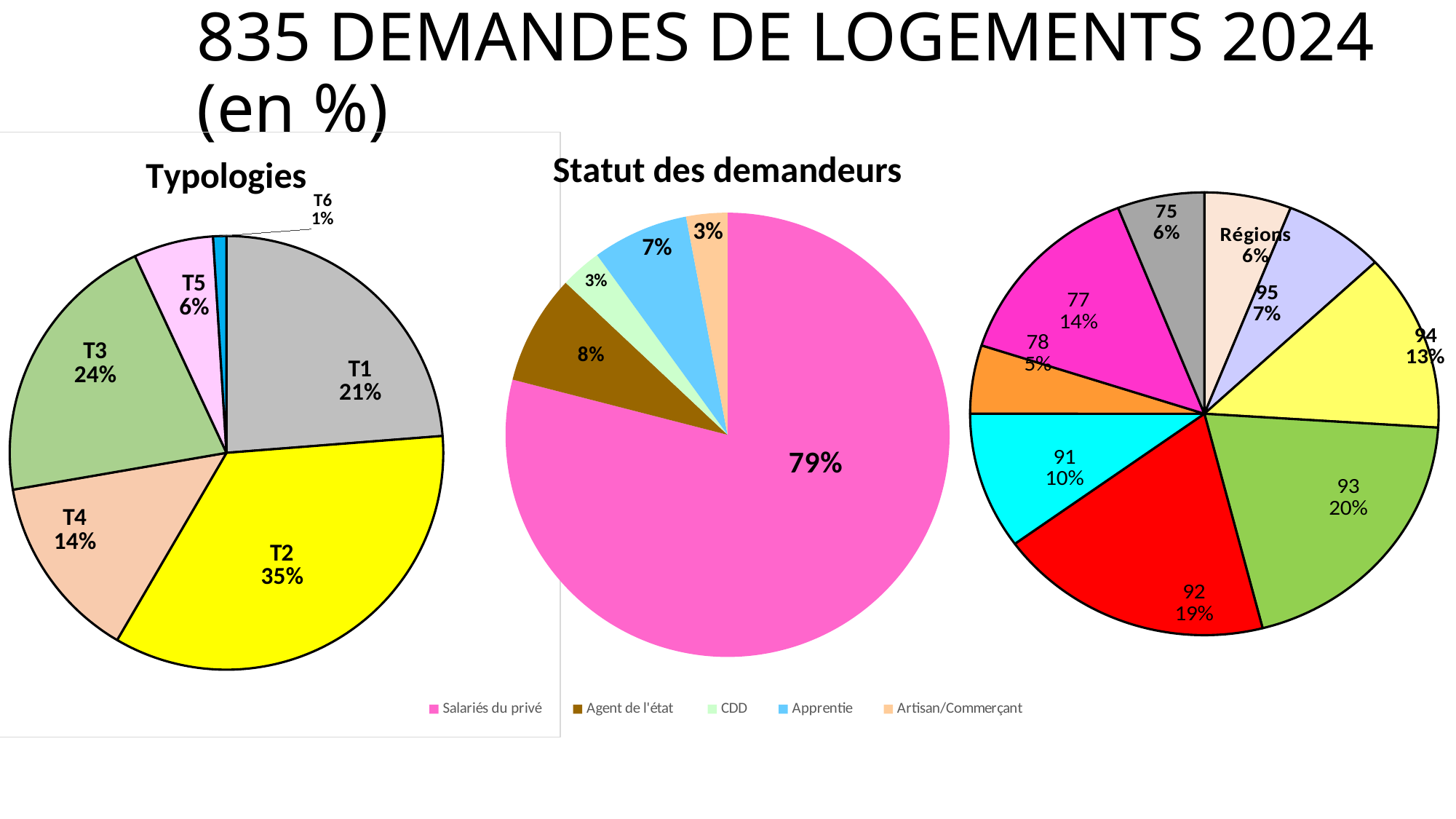
In the right-hand pie chart, what share is shown for 93? 20% In the Typologies chart, what share is shown for T2? 35% In the Statut des demandeurs chart, what share is shown for Apprentie? 7% In the Typologies chart, what is the difference between the shares of T3 and T4? 10% In the Typologies chart, which typology has the smallest share? T6 How many entries does the legend of the Statut des demandeurs chart list? 5 What type of chart is used for Typologies? Pie chart In the Statut des demandeurs chart, which is larger, Agent de l'état or Apprentie? Agent de l'état In the right-hand pie chart, what is the difference between the shares of 92 and 91? 9% In the right-hand pie chart, which category has the largest share? 93 How many slices does the Typologies pie chart have? 6 In the Statut des demandeurs chart, what share is shown for Salariés du privé? 79%